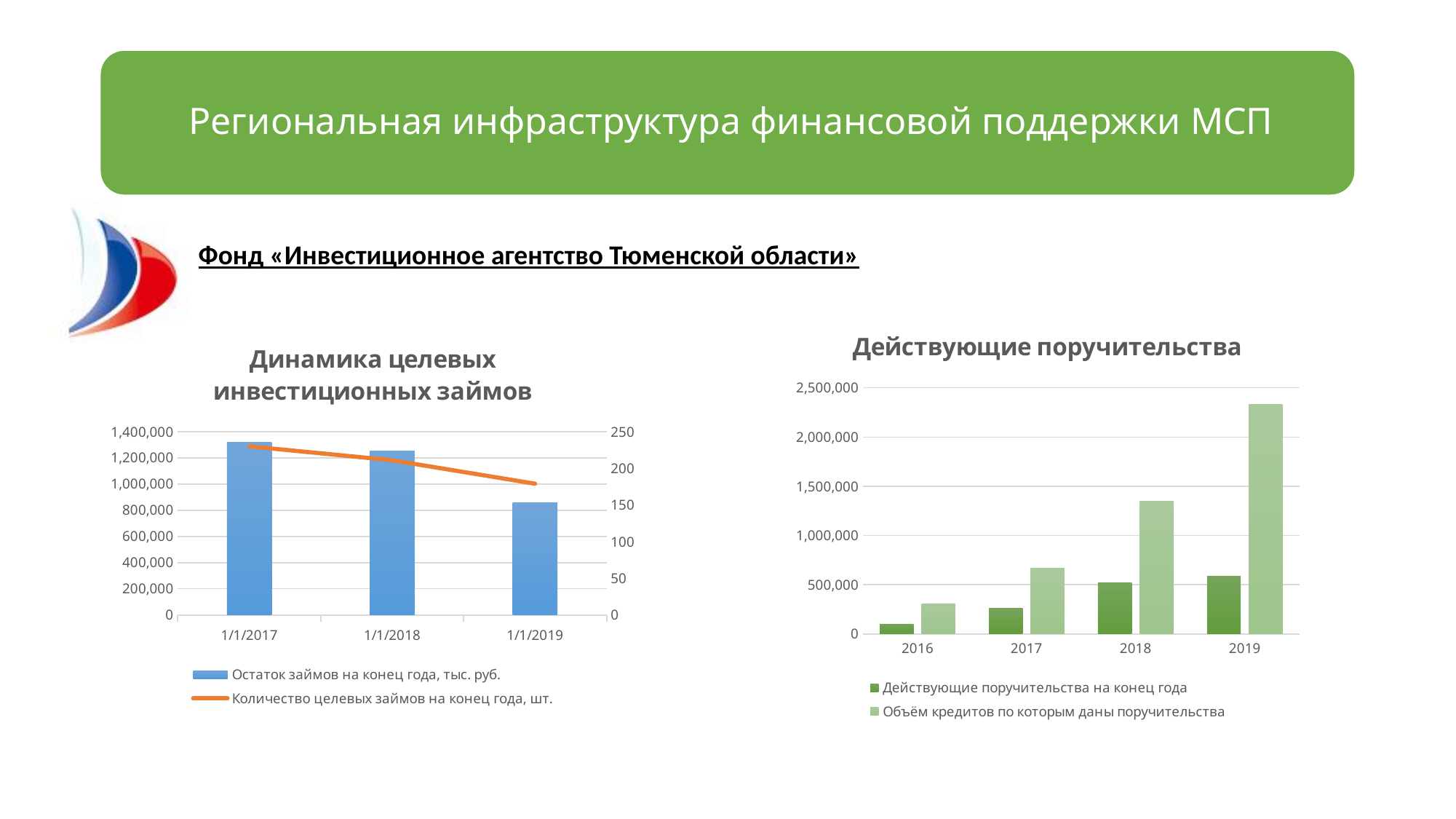
What kind of chart is the chart titled "Действующие поручительства"? bar chart In the chart titled "Действующие поручительства", is the value for "Объём кредитов по которым даны поручительства" in 2019 greater or less than 2,000,000? greater In the chart titled "Действующие поручительства", which year has the lowest value for "Действующие поручительства на конец года"? 2016 In the chart titled "Действующие поручительства", which year has the highest value for "Объём кредитов по которым даны поручительства"? 2019 How many series does the legend of the chart titled "Действующие поручительства" list? 2 In the chart titled "Действующие поручительства", do the values for "Объём кредитов по которым даны поручительства" rise or fall from 2016 to 2019? rise In the chart titled "Динамика целевых инвестиционных займов", do the values of the line "Количество целевых займов на конец года, шт." rise or fall from 1/1/2017 to 1/1/2019? fall How many years are shown on the x axis of the chart titled "Действующие поручительства"? 4 In the chart titled "Динамика целевых инвестиционных займов", what colour is the line for "Количество целевых займов на конец года, шт."? orange In the chart titled "Динамика целевых инвестиционных займов", which date has the highest value for "Остаток займов на конец года, тыс. руб."? 1/1/2017 How many dates are shown on the x axis of the chart titled "Динамика целевых инвестиционных займов"? 3 In the chart titled "Динамика целевых инвестиционных займов", is the value for "Остаток займов на конец года, тыс. руб." at 1/1/2019 greater or less than 1,000,000? less